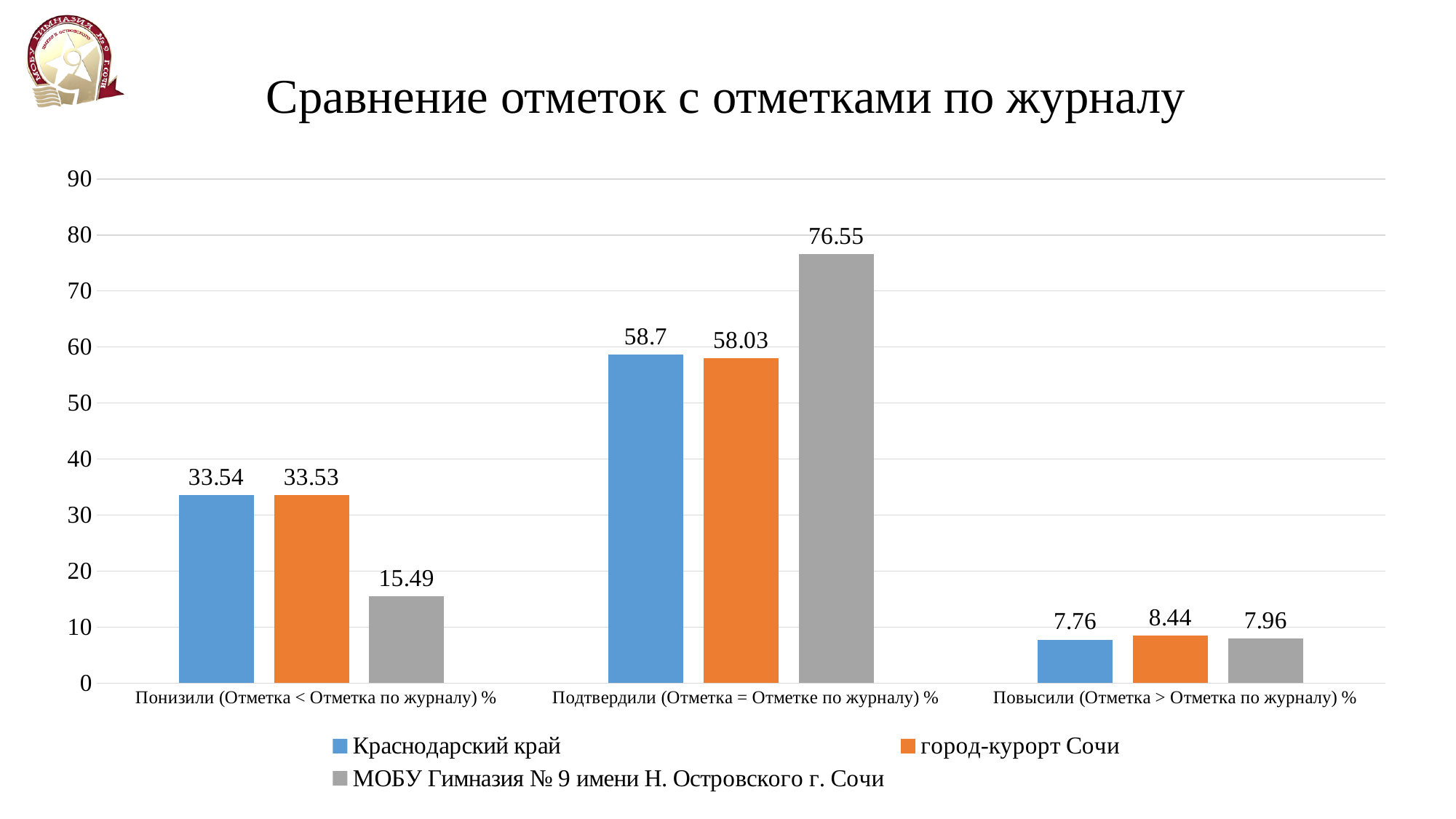
What is the difference between the МОБУ Гимназия № 9 value and the Краснодарский край value in the category Подтвердили (Отметка = Отметке по журналу) %? 17.85 How many series does the legend list? 3 What kind of chart is shown on the slide? bar chart What is the value for Краснодарский край in the category Подтвердили (Отметка = Отметке по журналу) %? 58.7 Is the value for МОБУ Гимназия № 9 in the category Подтвердили (Отметка = Отметке по журналу) % greater or less than 70? greater What is the value for МОБУ Гимназия № 9 имени Н. Островского г. Сочи in the category Понизили (Отметка < Отметка по журналу) %? 15.49 Which series has the highest value in the category Подтвердили (Отметка = Отметке по журналу) %? МОБУ Гимназия № 9 имени Н. Островского г. Сочи In the category Повысили (Отметка > Отметка по журналу) %, which is larger: the value for город-курорт Сочи or the value for Краснодарский край? город-курорт Сочи How many categories are shown on the x axis? 3 What is the difference between the Краснодарский край value and the МОБУ Гимназия № 9 value in the category Понизили (Отметка < Отметка по журналу) %? 18.05 Which series has the lowest value in the category Понизили (Отметка < Отметка по журналу) %? МОБУ Гимназия № 9 имени Н. Островского г. Сочи What is the value for город-курорт Сочи in the category Повысили (Отметка > Отметка по журналу) %? 8.44